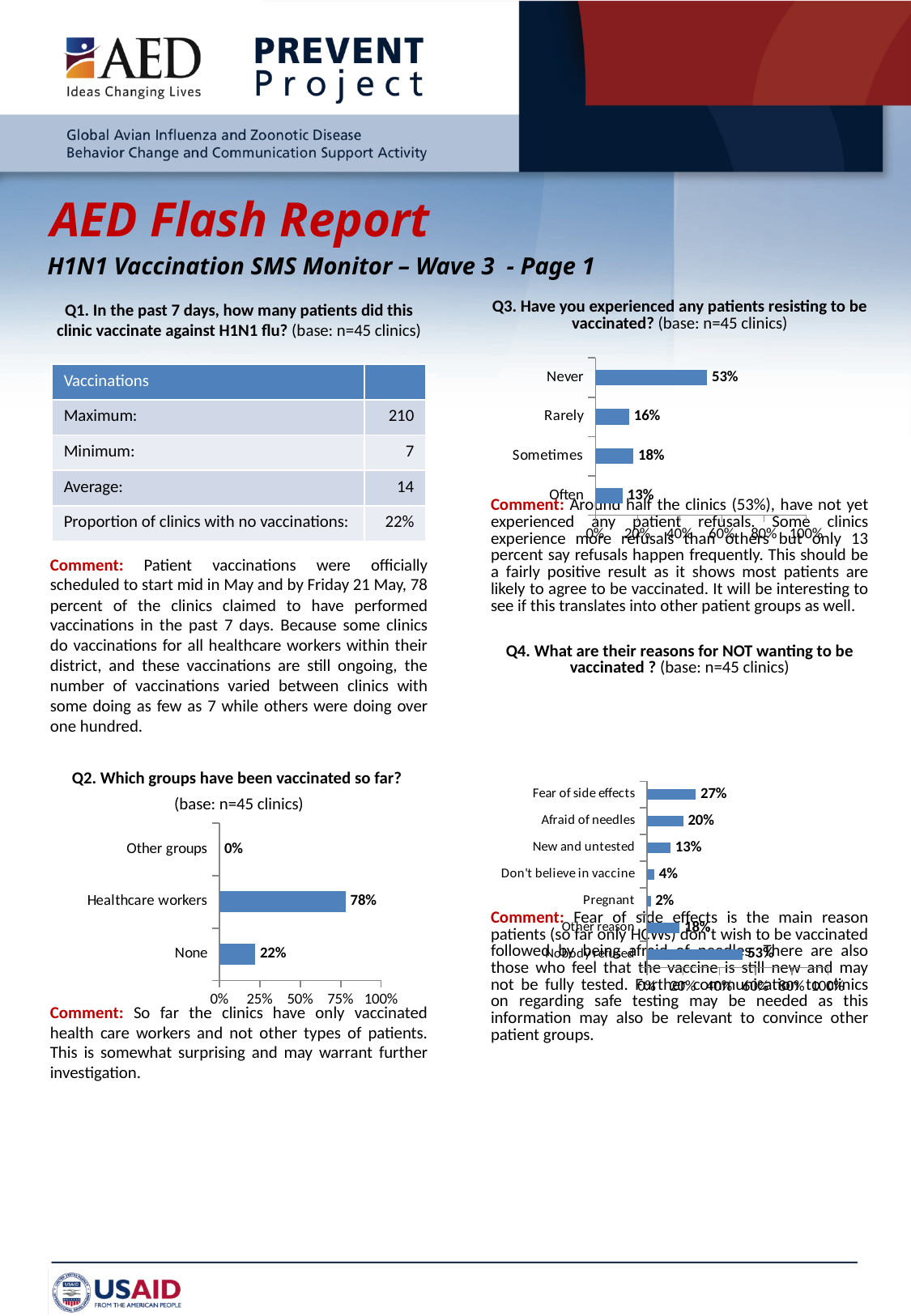
In the Q3 chart (Have you experienced any patients resisting to be vaccinated?), which category has the lowest value? Often In the Q3 chart (Have you experienced any patients resisting to be vaccinated?), what is the value for Never? 53% In the Q2 chart (Which groups have been vaccinated so far?), what is the value for None? 22% In the Q2 chart (Which groups have been vaccinated so far?), how many categories are shown? 3 In the Q4 chart (What are their reasons for NOT wanting to be vaccinated?), what is the difference between Afraid of needles and New and untested? 7% In the Q4 chart (What are their reasons for NOT wanting to be vaccinated?), which category has the highest value? Nobody refused In the Q4 chart (What are their reasons for NOT wanting to be vaccinated?), how many categories are shown? 7 In the Q3 chart (Have you experienced any patients resisting to be vaccinated?), what kind of chart is it? Bar chart In the Q4 chart (What are their reasons for NOT wanting to be vaccinated?), what is the value for Fear of side effects? 27% In the Q2 chart (Which groups have been vaccinated so far?), what is the difference between Healthcare workers and None? 56% In the Q2 chart (Which groups have been vaccinated so far?), what is the value for Healthcare workers? 78% In the Q3 chart (Have you experienced any patients resisting to be vaccinated?), which is larger, Rarely or Sometimes? Sometimes